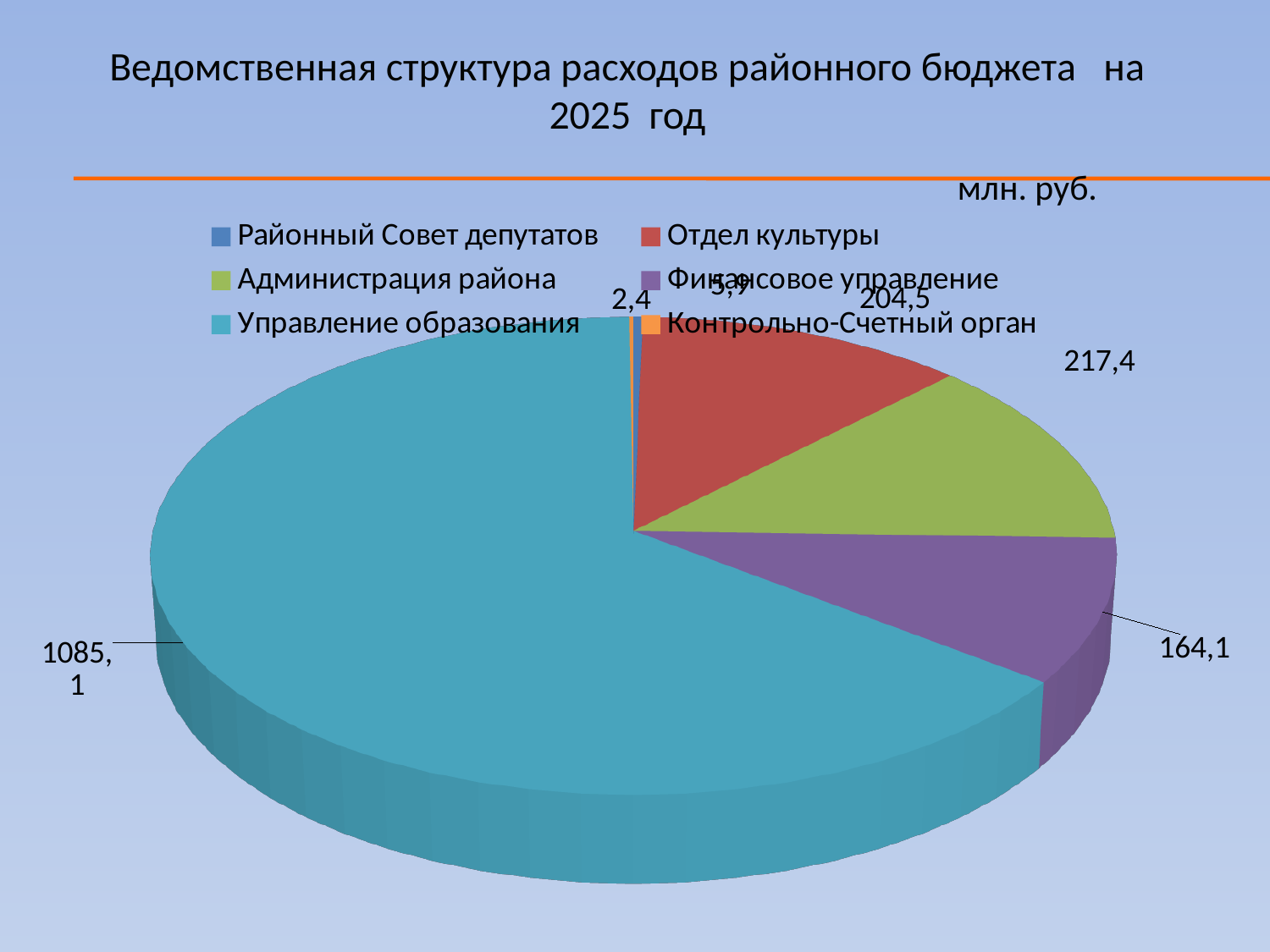
What is the value for Управление образования? 1085,1 What is the value for Финансовое управление? 164,1 How many categories does the legend list? 6 What kind of chart is shown on the slide? pie chart What is the value for Отдел культуры? 204,5 What is the difference between the values for Администрация района and Отдел культуры? 12,9 What unit is indicated for the values on the chart? млн. руб. What is the value for Администрация района? 217,4 Which is larger: the value for Финансовое управление or the value for Отдел культуры? Отдел культуры Which year does the chart title refer to? 2025 Which category has the largest slice of the pie? Управление образования What is the difference between the values for Управление образования and Администрация района? 867,7